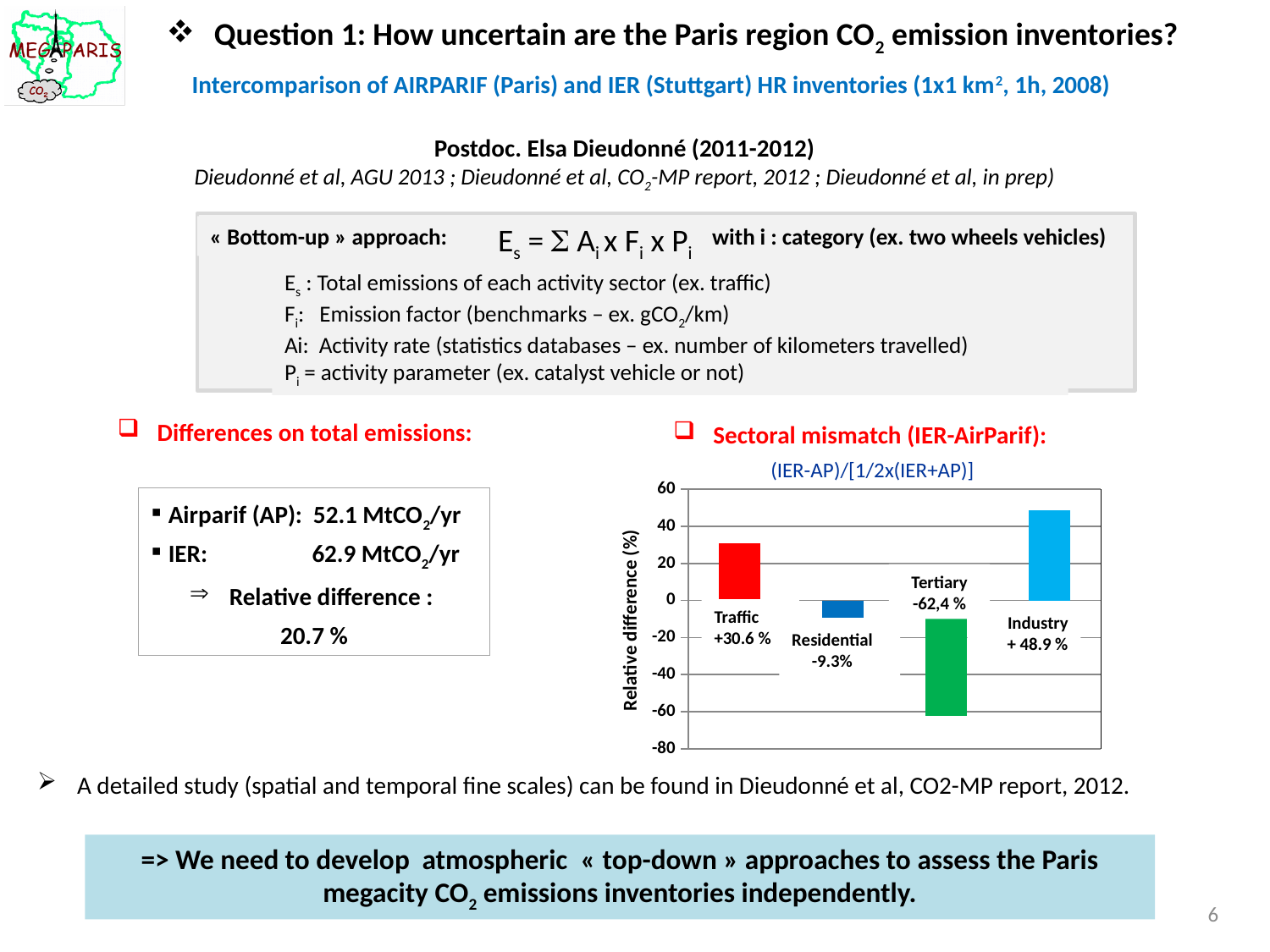
What is the relative difference for Tertiary in the Sectoral mismatch chart? -62,4 % Which sector has the lowest relative difference in the Sectoral mismatch chart? Tertiary What is the relative difference for Residential in the Sectoral mismatch chart? -9.3% In the Sectoral mismatch chart, by how many percentage points does the Industry value exceed the Traffic value? 18.3 Which sector has the highest relative difference in the Sectoral mismatch chart? Industry What is the relative difference for Industry in the Sectoral mismatch chart? + 48.9 % How many sectors are plotted in the Sectoral mismatch chart? 4 In the Sectoral mismatch chart, which has the larger relative difference, Traffic or Industry? Industry In the Sectoral mismatch chart, is the value for Industry greater or less than 40? greater What is the relative difference for Traffic in the Sectoral mismatch chart? +30.6 % What kind of chart is the Sectoral mismatch chart? bar chart What is the y-axis title of the Sectoral mismatch chart? Relative difference (%)